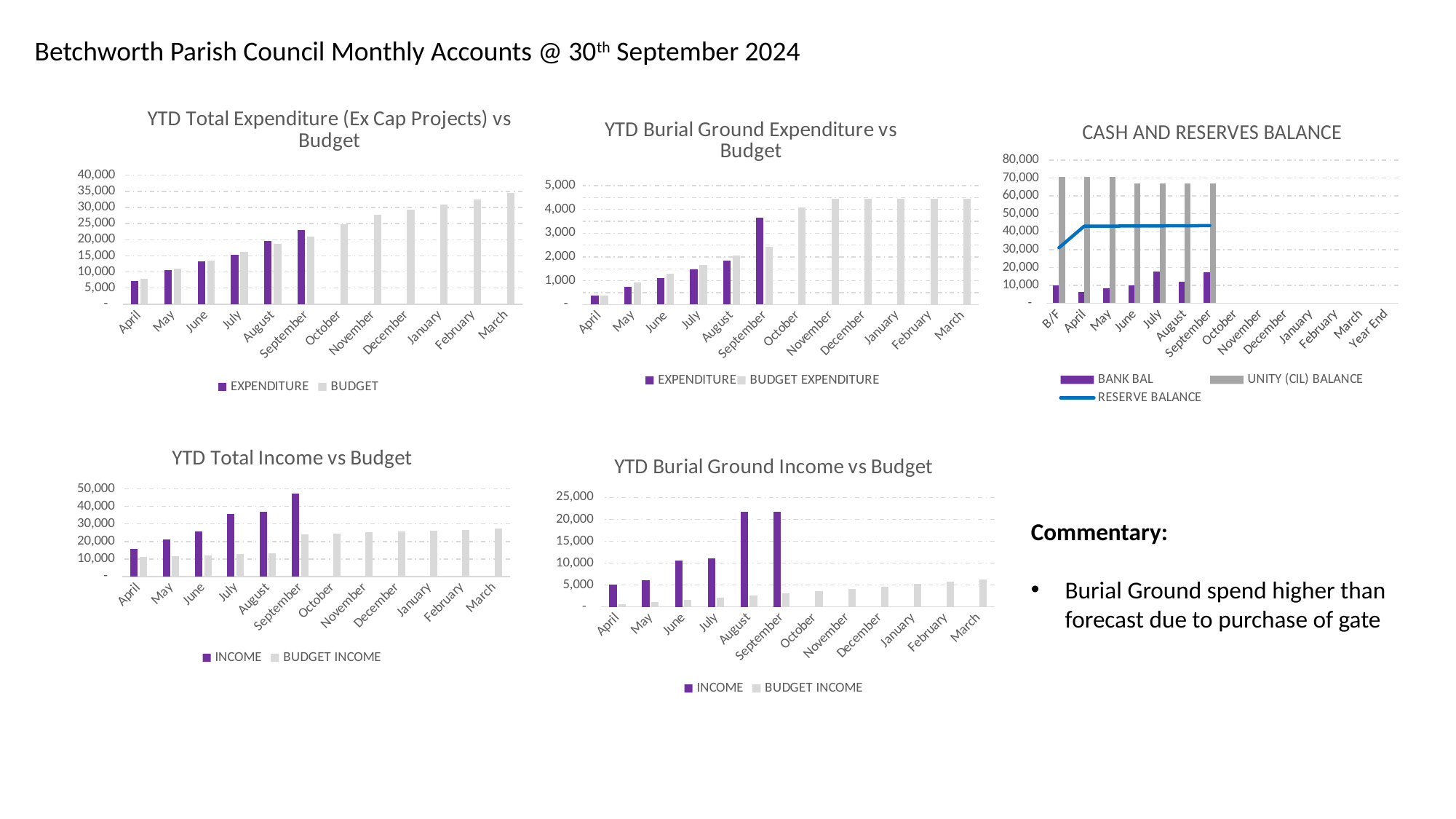
In the "YTD Total Income vs Budget" chart, which month has the highest INCOME value? September In the "YTD Total Expenditure (Ex Cap Projects) vs Budget" chart, do the BUDGET values rise or fall from April to March? rise In the "YTD Burial Ground Income vs Budget" chart, how many months are shown on the x axis? 12 In the "CASH AND RESERVES BALANCE" chart, which series is drawn as a line rather than bars? RESERVE BALANCE In the "YTD Burial Ground Expenditure vs Budget" chart, which is larger for September: EXPENDITURE or BUDGET EXPENDITURE? EXPENDITURE In the "YTD Total Expenditure (Ex Cap Projects) vs Budget" chart, is the EXPENDITURE value for September greater or less than 20,000? greater In the "CASH AND RESERVES BALANCE" chart, is the UNITY (CIL) BALANCE value for B/F greater or less than 60,000? greater In the "YTD Total Expenditure (Ex Cap Projects) vs Budget" chart, how many series does the legend list? 2 In the "YTD Burial Ground Expenditure vs Budget" chart, is the EXPENDITURE value for September greater or less than 3,000? greater What kind of chart is the "YTD Total Expenditure (Ex Cap Projects) vs Budget" chart? Bar chart In the "CASH AND RESERVES BALANCE" chart, how many series does the legend list? 3